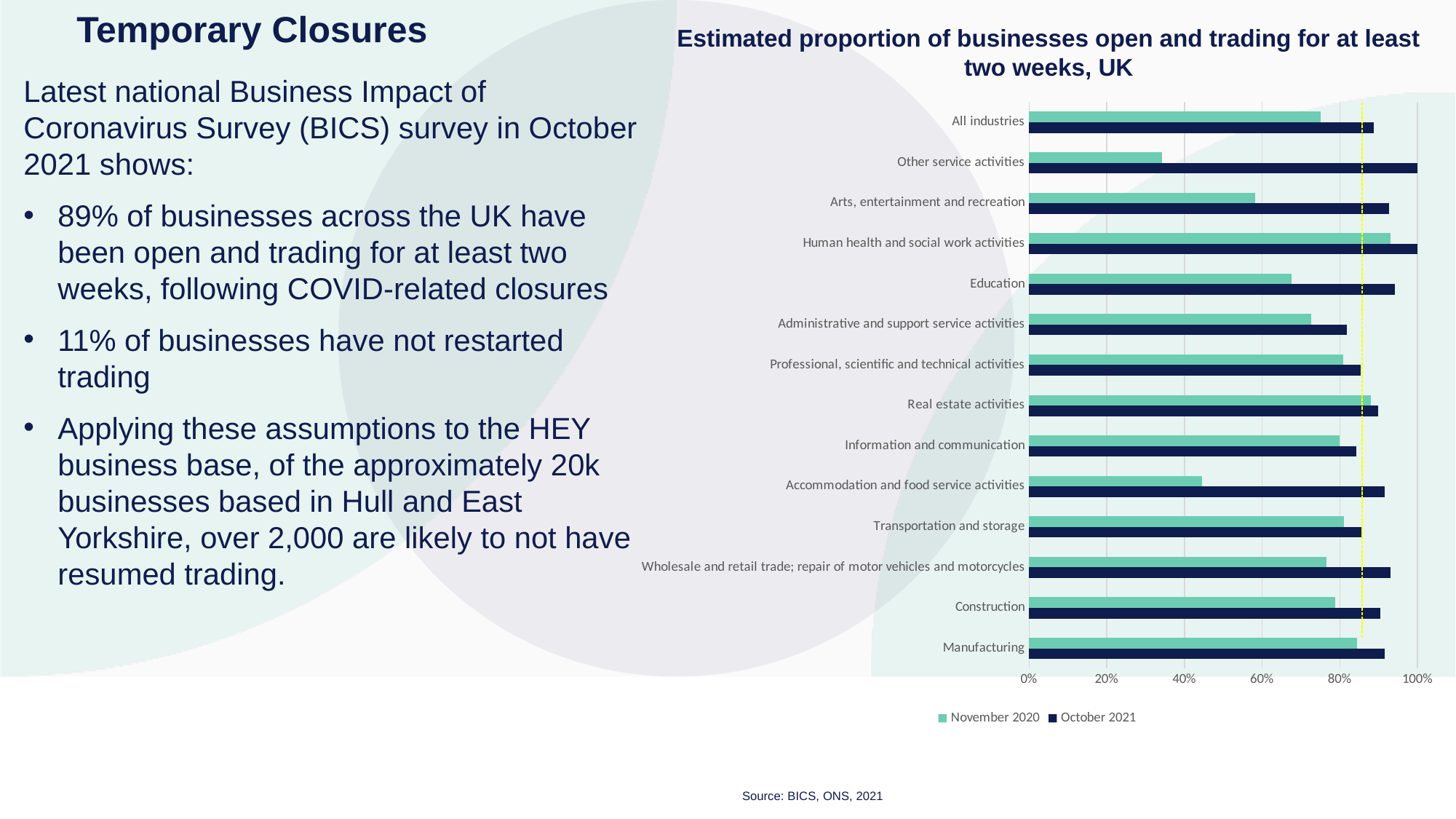
Is the November 2020 value for Arts, entertainment and recreation greater or less than 60%? less Is the October 2021 value for Other service activities greater or less than 80%? greater How many series does the chart legend list? 2 Which category has the lowest November 2020 value? Other service activities What kind of chart is shown on the slide? bar chart How many industry categories are plotted on the chart? 14 For Other service activities, which is larger: the November 2020 value or the October 2021 value? October 2021 Which has the larger November 2020 value: Arts, entertainment and recreation or Accommodation and food service activities? Arts, entertainment and recreation Which category has the highest November 2020 value? Human health and social work activities Is the November 2020 value for Accommodation and food service activities greater or less than 40%? greater What is the title of the chart? Estimated proportion of businesses open and trading for at least two weeks, UK